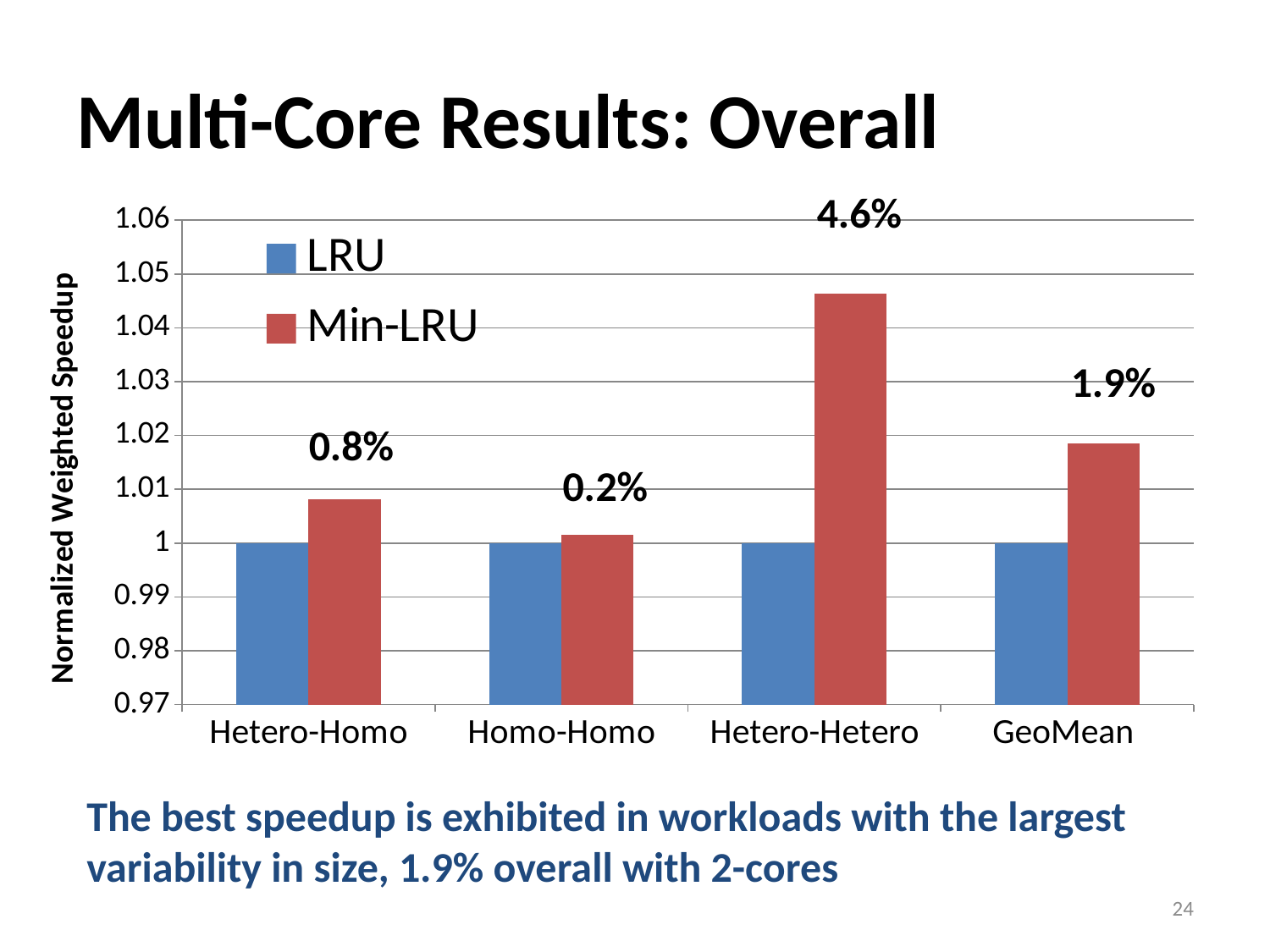
Is the Min-LRU value for GeoMean greater or less than 1.03? less What kind of chart is shown on the slide? bar chart How many series does the legend list? 2 What percentage label is printed above the Min-LRU bar for GeoMean? 1.9% What is the title of the y axis? Normalized Weighted Speedup Is the Min-LRU value for Hetero-Hetero greater or less than 1.04? greater Which category has the lowest Min-LRU bar? Homo-Homo What percentage label is printed above the Min-LRU bar for Hetero-Hetero? 4.6% What percentage label is printed above the Min-LRU bar for Homo-Homo? 0.2% What is the normalized weighted speedup of LRU for Hetero-Homo? 1 How many workload categories are shown on the x axis? 4 Which category has the highest Min-LRU bar? Hetero-Hetero